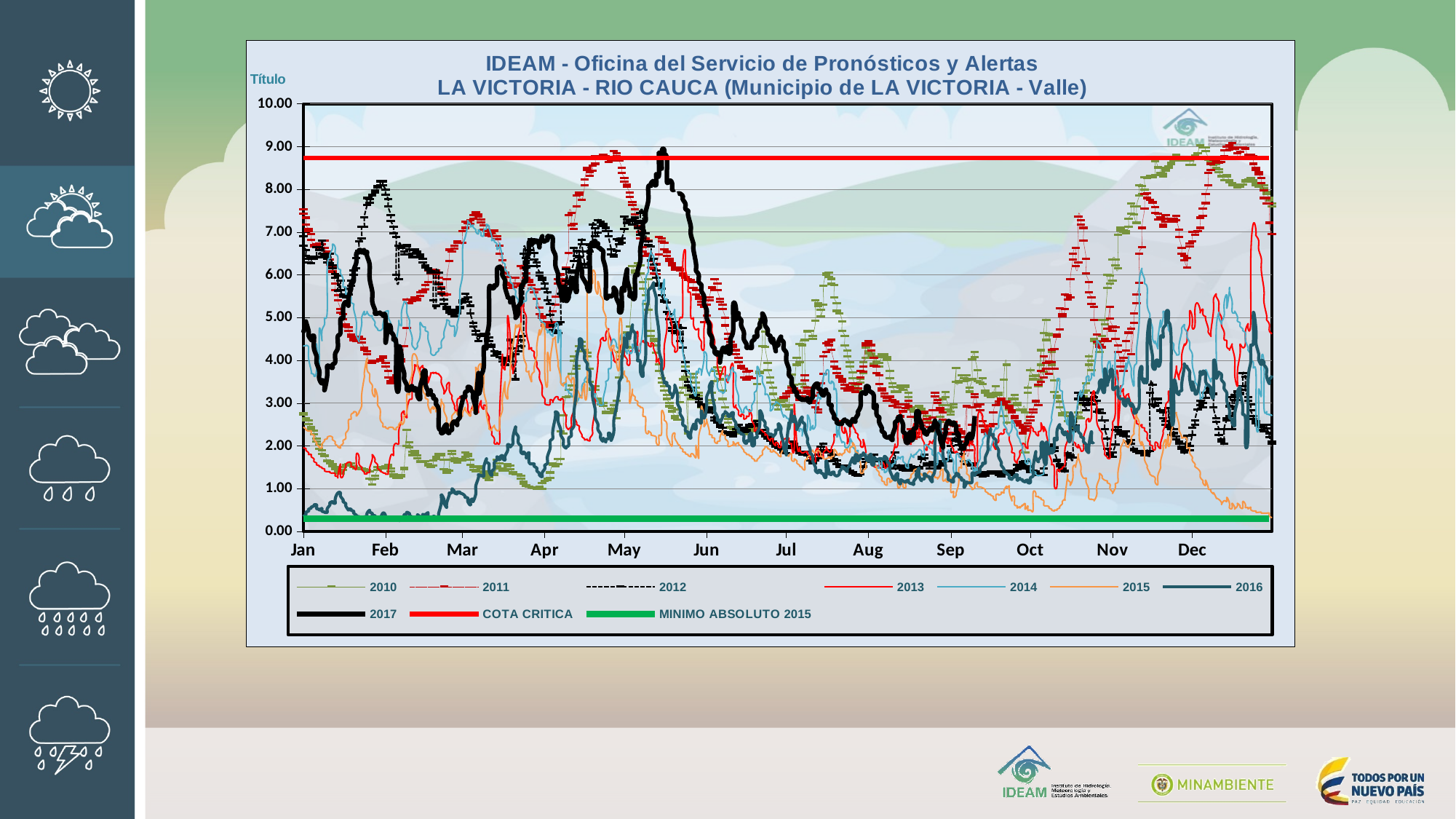
Does the 2017 series rise or fall from June to August? fall What station name appears in the second line of the chart title? LA VICTORIA - RIO CAUCA (Municipio de LA VICTORIA - Valle) How many series does the legend list? 10 What kind of chart is shown on the slide? line chart Does the 2011 series rise or fall from October to December? rise Is the value of the 2015 series at the end of December greater or less than 2.00? less How many months are labelled along the x axis? 12 Is the peak of the 2017 series in late May greater or less than 8.00? greater Is the value of the 2016 series at the start of January greater or less than 1.00? less Which series is drawn as a thick solid black line? 2017